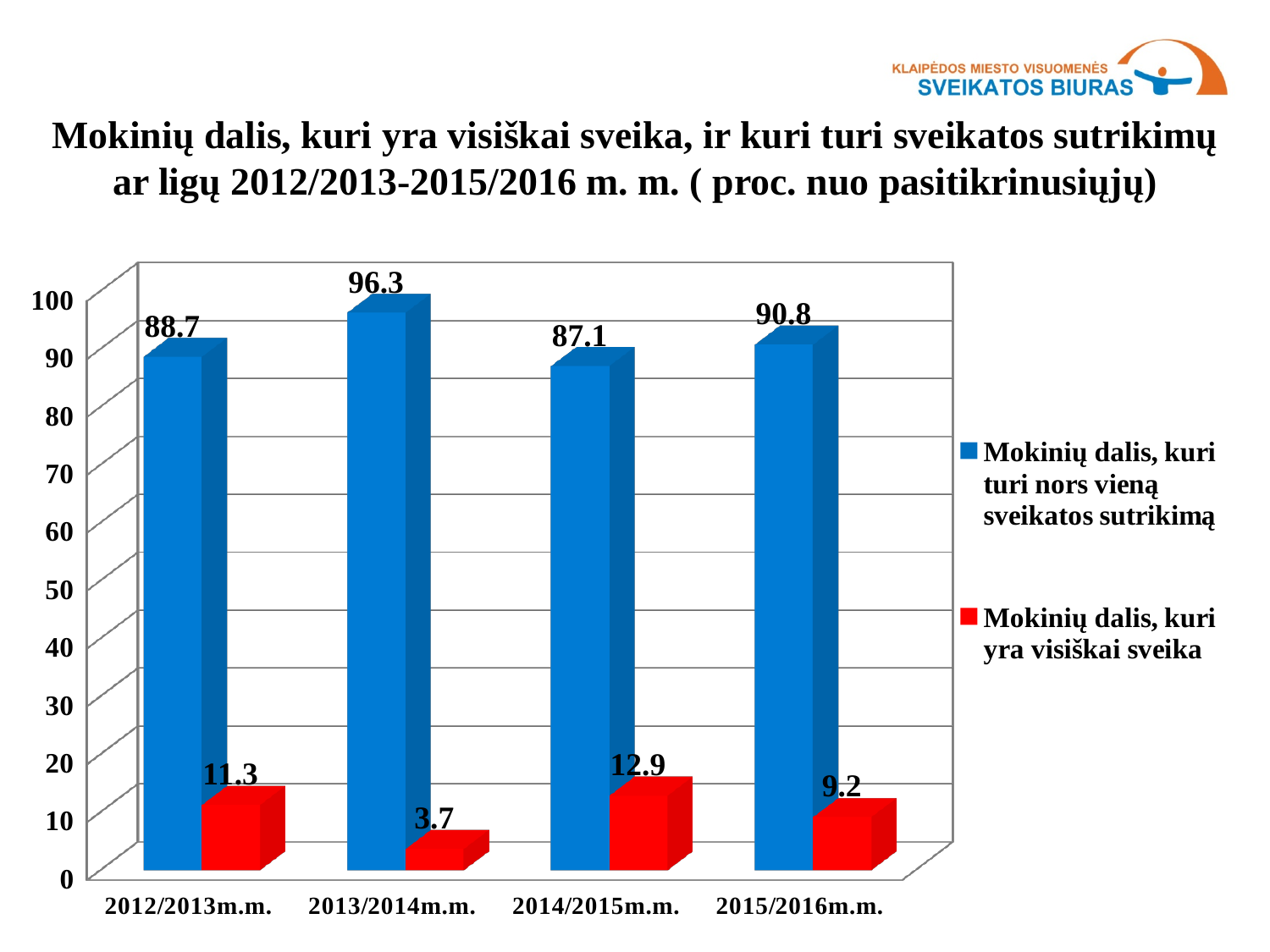
What is the value for 'Mokinių dalis, kuri yra visiškai sveika' in 2015/2016m.m.? 9.2 What is the value for 'Mokinių dalis, kuri turi nors vieną sveikatos sutrikimą' in 2013/2014m.m.? 96.3 What is the difference between the 'Mokinių dalis, kuri turi nors vieną sveikatos sutrikimą' values for 2013/2014m.m. and 2014/2015m.m.? 9.2 What is the value for 'Mokinių dalis, kuri turi nors vieną sveikatos sutrikimą' in 2012/2013m.m.? 88.7 How many school years are shown on the x axis? 4 In which school year is 'Mokinių dalis, kuri turi nors vieną sveikatos sutrikimą' the lowest? 2014/2015m.m. In which school year is 'Mokinių dalis, kuri yra visiškai sveika' the highest? 2014/2015m.m. Which is larger: 'Mokinių dalis, kuri yra visiškai sveika' in 2012/2013m.m. or in 2015/2016m.m.? 2012/2013m.m. How many series does the legend list? 2 Is the value for 'Mokinių dalis, kuri turi nors vieną sveikatos sutrikimą' in 2015/2016m.m. greater or less than 80? greater In which school year is 'Mokinių dalis, kuri yra visiškai sveika' the lowest? 2013/2014m.m. What kind of chart is shown on the slide? bar chart